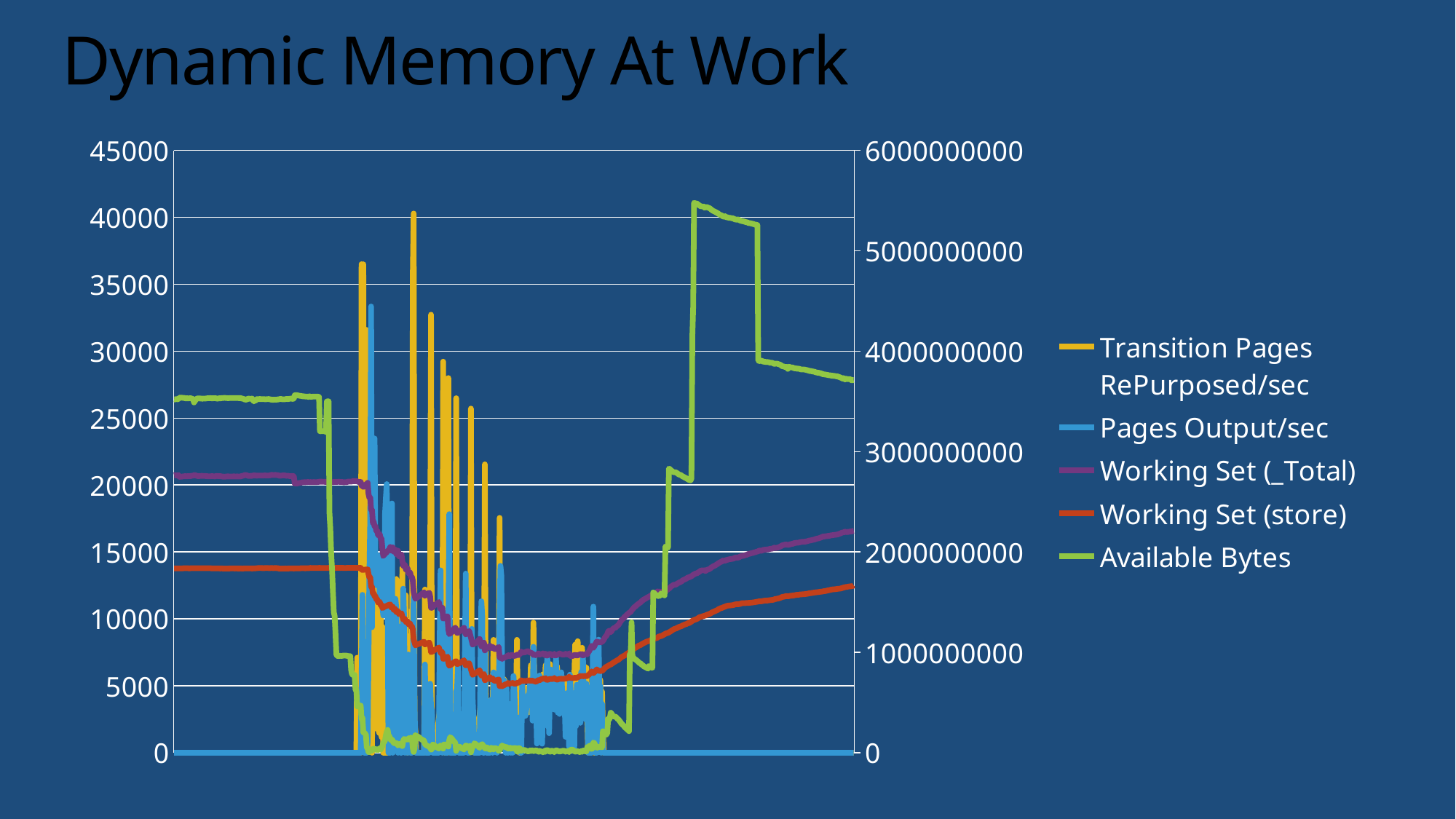
Which colour is used for the Available Bytes series? green Does the Available Bytes series rise or fall over the first third of the chart? fall What is the title of the slide containing the chart? Dynamic Memory At Work Is the peak value of the Pages Output/sec series greater or less than 30000 on the left axis? greater What kind of chart is shown on the slide? line chart Which series reaches the highest point on the left axis, Transition Pages RePurposed/sec or Pages Output/sec? Transition Pages RePurposed/sec How many series does the legend list? 5 What is the highest tick value shown on the right vertical axis? 6000000000 Is the peak value of the Available Bytes series greater or less than 5000000000 on the right axis? greater What is the highest tick value shown on the left vertical axis? 45000 Does the Working Set (store) series rise or fall over the final third of the chart? rise Is the value of Available Bytes at the start of the chart greater or less than 3000000000 on the right axis? greater